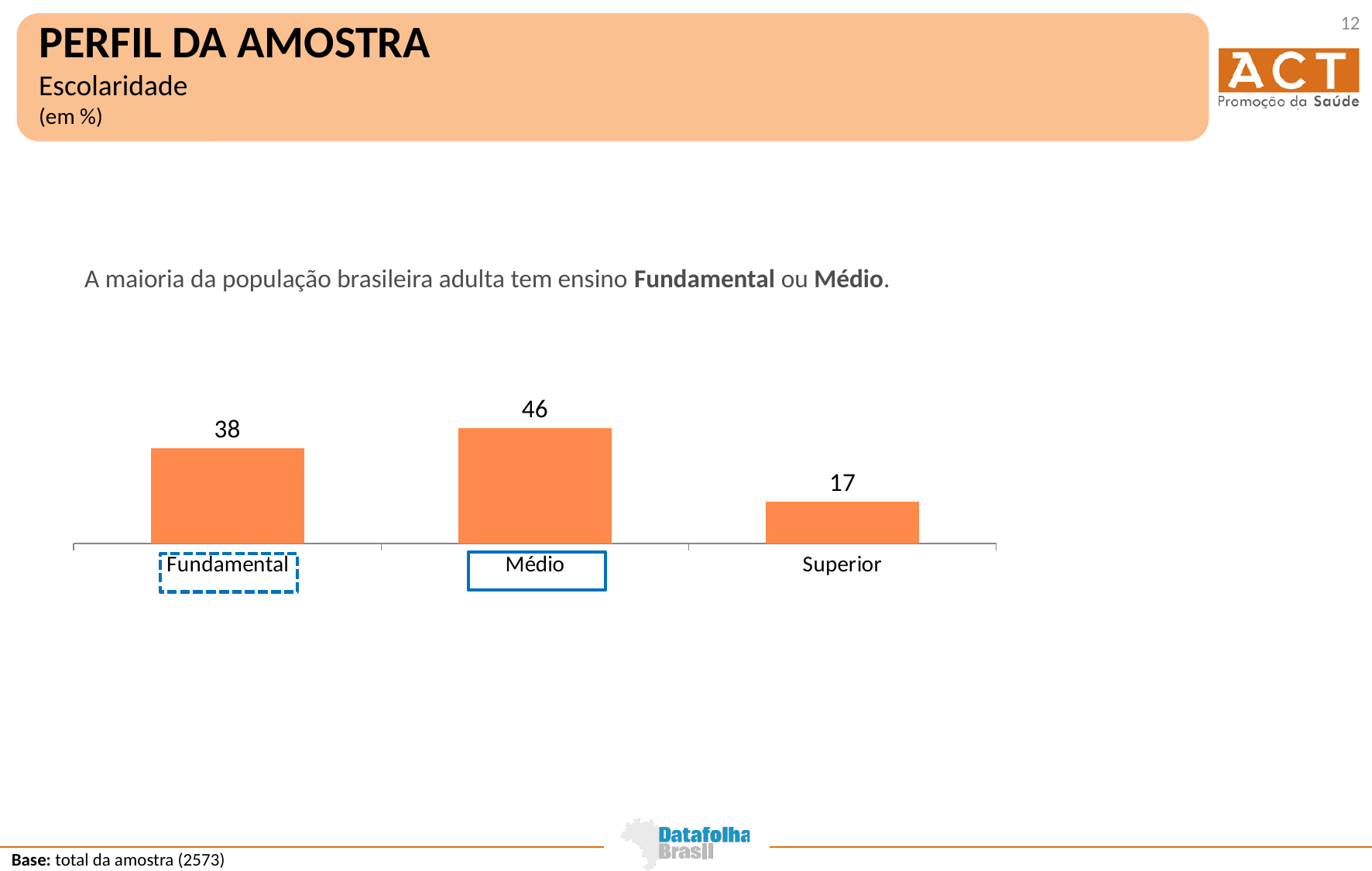
Which category has the lowest value? Superior How many categories are shown in the chart? 3 What kind of chart is shown on the slide? bar chart Which is larger, the value for Fundamental or the value for Superior? Fundamental What is the difference between the values for Médio and Fundamental? 8 What is the value for Fundamental? 38 What is the total of the three values shown in the chart? 101 What is the base (sample size) stated at the bottom of the slide? 2573 What is the value for Médio? 46 Which category has the highest value? Médio What is the value for Superior? 17 What is the difference between the values for Fundamental and Superior? 21